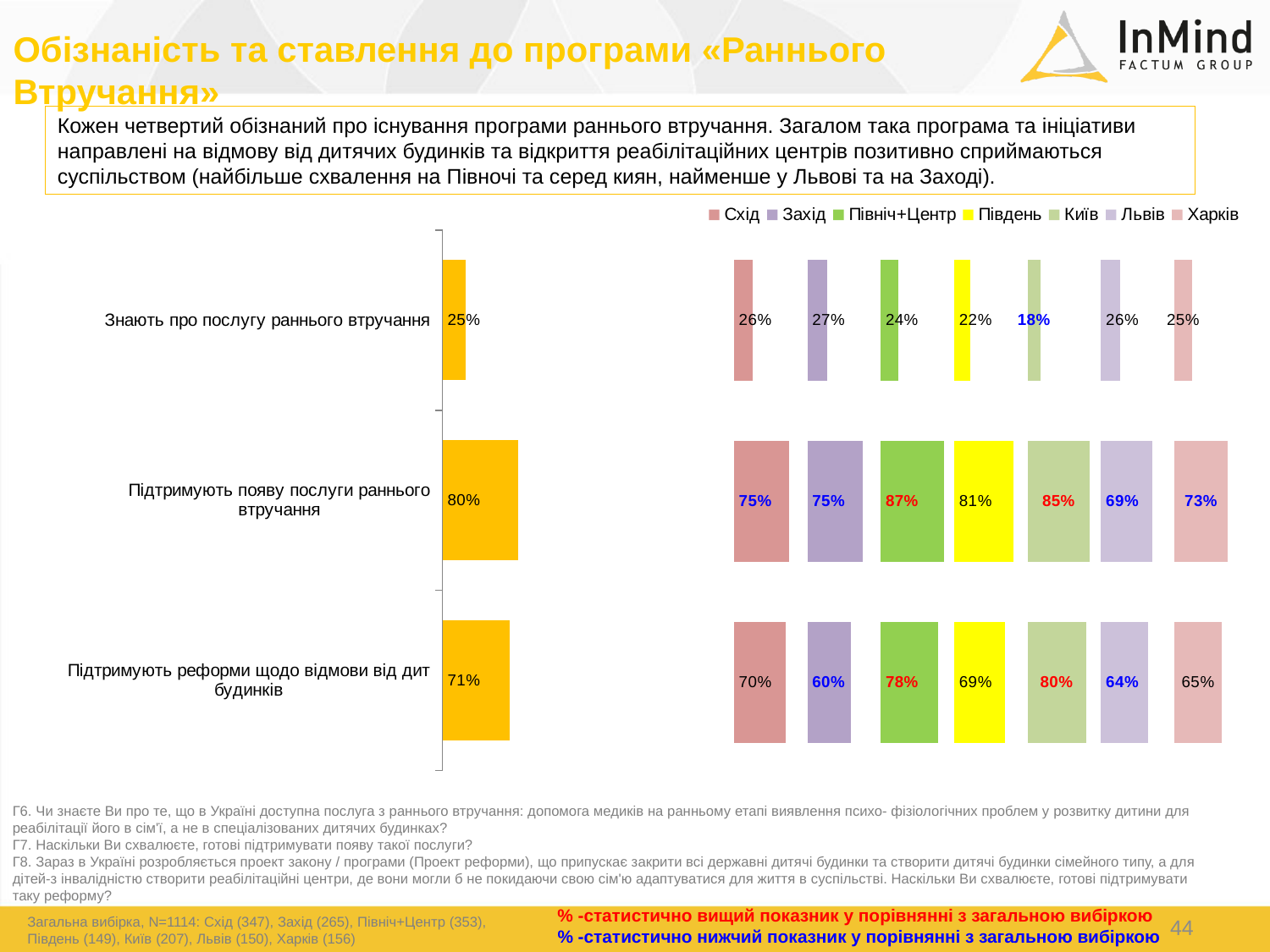
On the left chart, what is the difference between "Підтримують появу послуги раннього втручання" and "Підтримують реформи щодо відмови від дит будинків"? 9 percentage points On the left chart, what is the value for "Підтримують появу послуги раннього втручання"? 80% On the right chart, which region has the lowest value for "Підтримують реформи щодо відмови від дит будинків"? Захід On the right chart, how many series does the legend list? 7 On the right chart, which region has the highest value for "Підтримують появу послуги раннього втручання"? Північ+Центр On the left chart, which category has the highest value? Підтримують появу послуги раннього втручання On the right chart, what is the difference between Північ+Центр and Львів for "Підтримують появу послуги раннього втручання"? 18 percentage points On the left chart, which category has the lowest value? Знають про послугу раннього втручання On the right chart, for "Підтримують реформи щодо відмови від дит будинків", which is larger: Схід or Львів? Схід What kind of chart is the left chart? Bar chart On the left chart, how many categories are shown? 3 On the right chart, what is the value for Київ in the row "Знають про послугу раннього втручання"? 18%